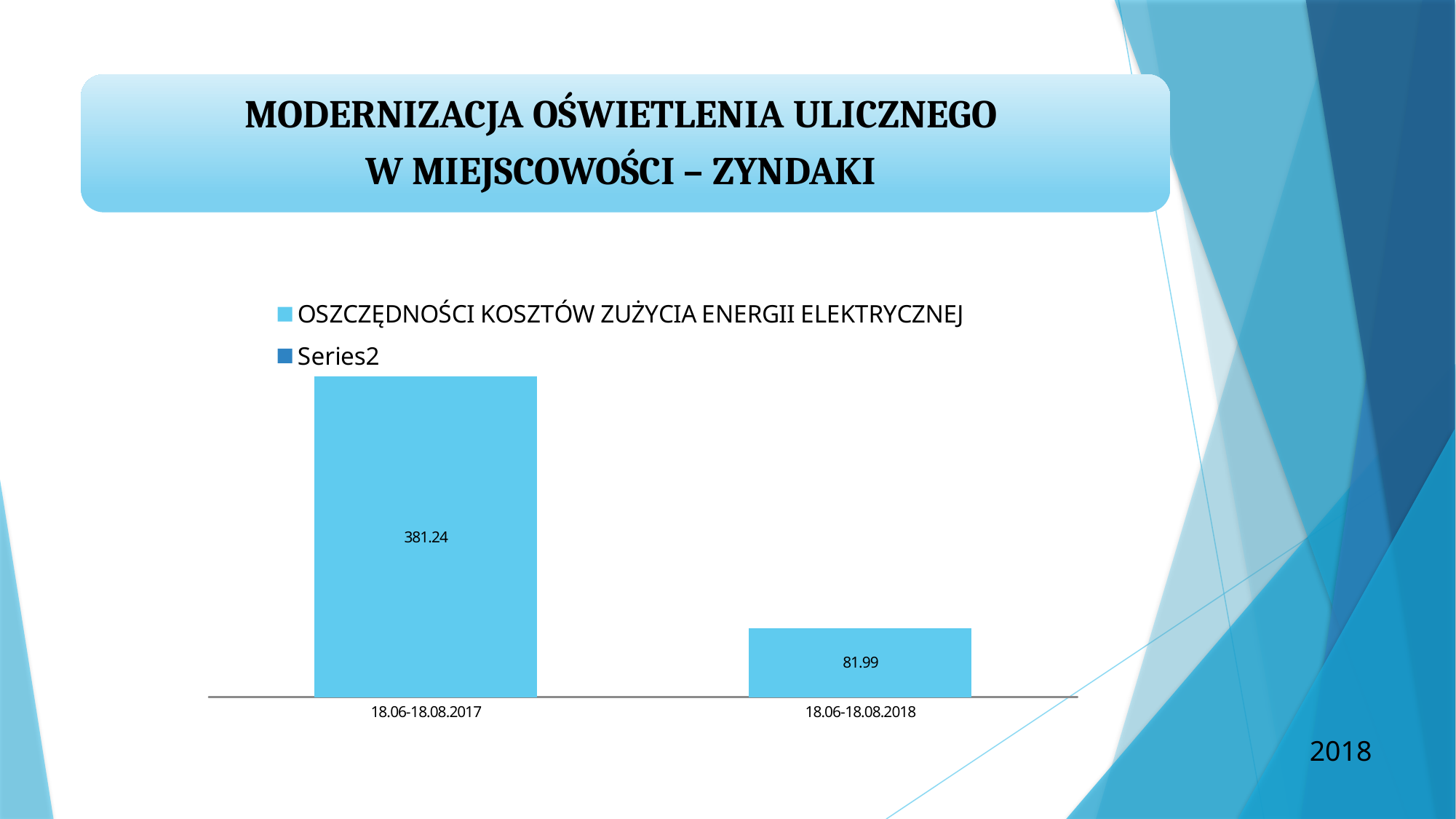
What is the value for 18.06-18.08.2017? 381.24 Do the values rise or fall from 18.06-18.08.2017 to 18.06-18.08.2018? fall What kind of chart is shown on the slide? bar chart What is the value for 18.06-18.08.2018? 81.99 What is the difference between the values for 18.06-18.08.2017 and 18.06-18.08.2018? 299.25 Which period has the lowest value? 18.06-18.08.2018 Which is larger, the value for 18.06-18.08.2017 or for 18.06-18.08.2018? 18.06-18.08.2017 Which period has the highest value? 18.06-18.08.2017 How many series does the legend list? 2 What is the first legend entry of the chart? OSZCZĘDNOŚCI KOSZTÓW ZUŻYCIA ENERGII ELEKTRYCZNEJ How many bars are plotted in the chart? 2 What is the second legend entry of the chart? Series2